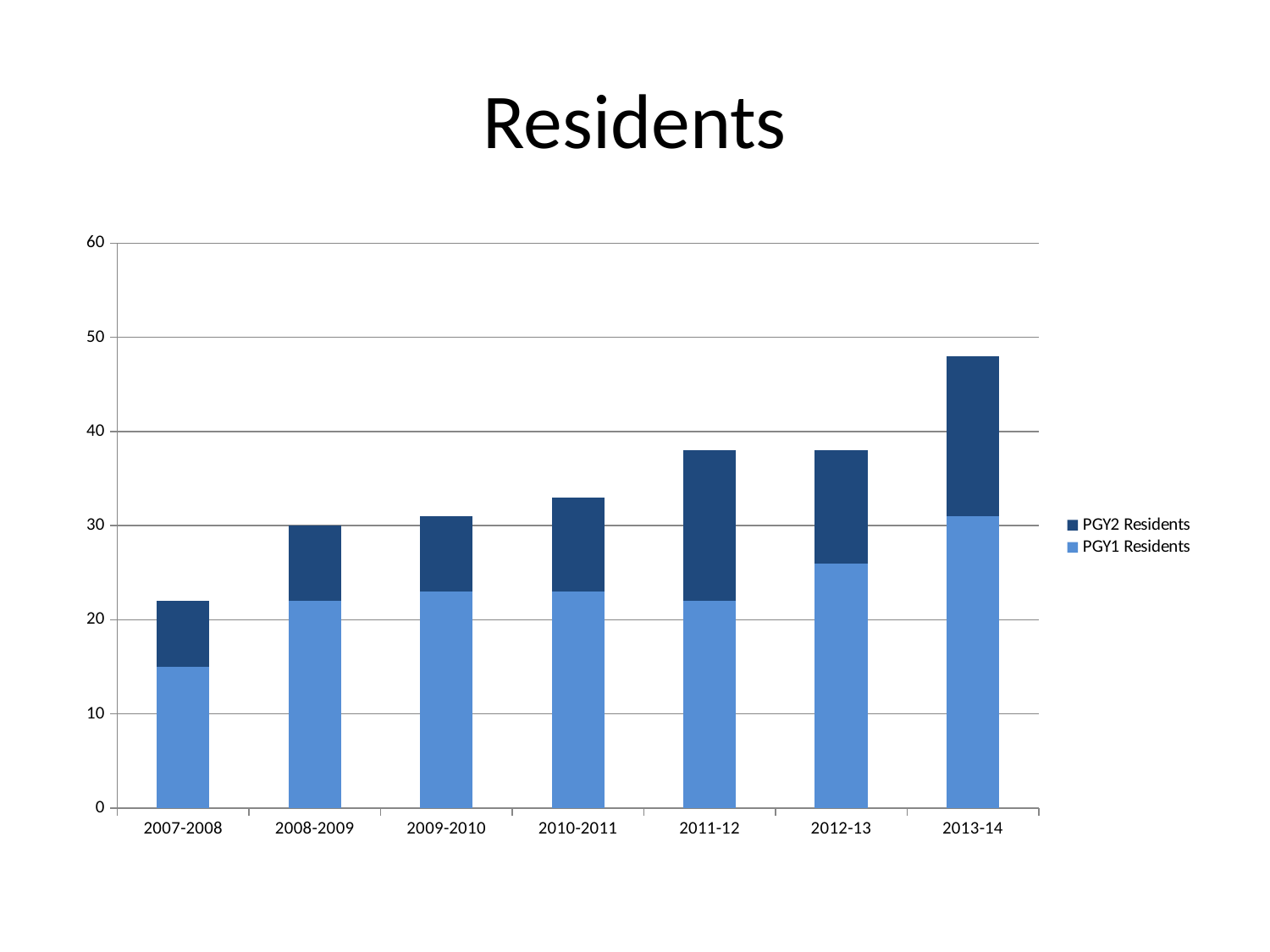
How many series does the legend list? 2 What is the title of the chart? Residents Is the PGY1 Residents value for 2007-2008 greater or less than 20? less How many academic years are shown on the x axis? 7 Is the total height of the bar for 2013-14 greater or less than 40? greater Which has the taller stacked bar, 2010-2011 or 2013-14? 2013-14 Is the PGY1 Residents value for 2012-13 greater or less than 20? greater What kind of chart is shown on the slide? bar chart Which academic year has the shortest stacked bar? 2007-2008 Do the total bar heights generally rise or fall from 2007-2008 to 2013-14? rise Which academic year has the tallest stacked bar? 2013-14